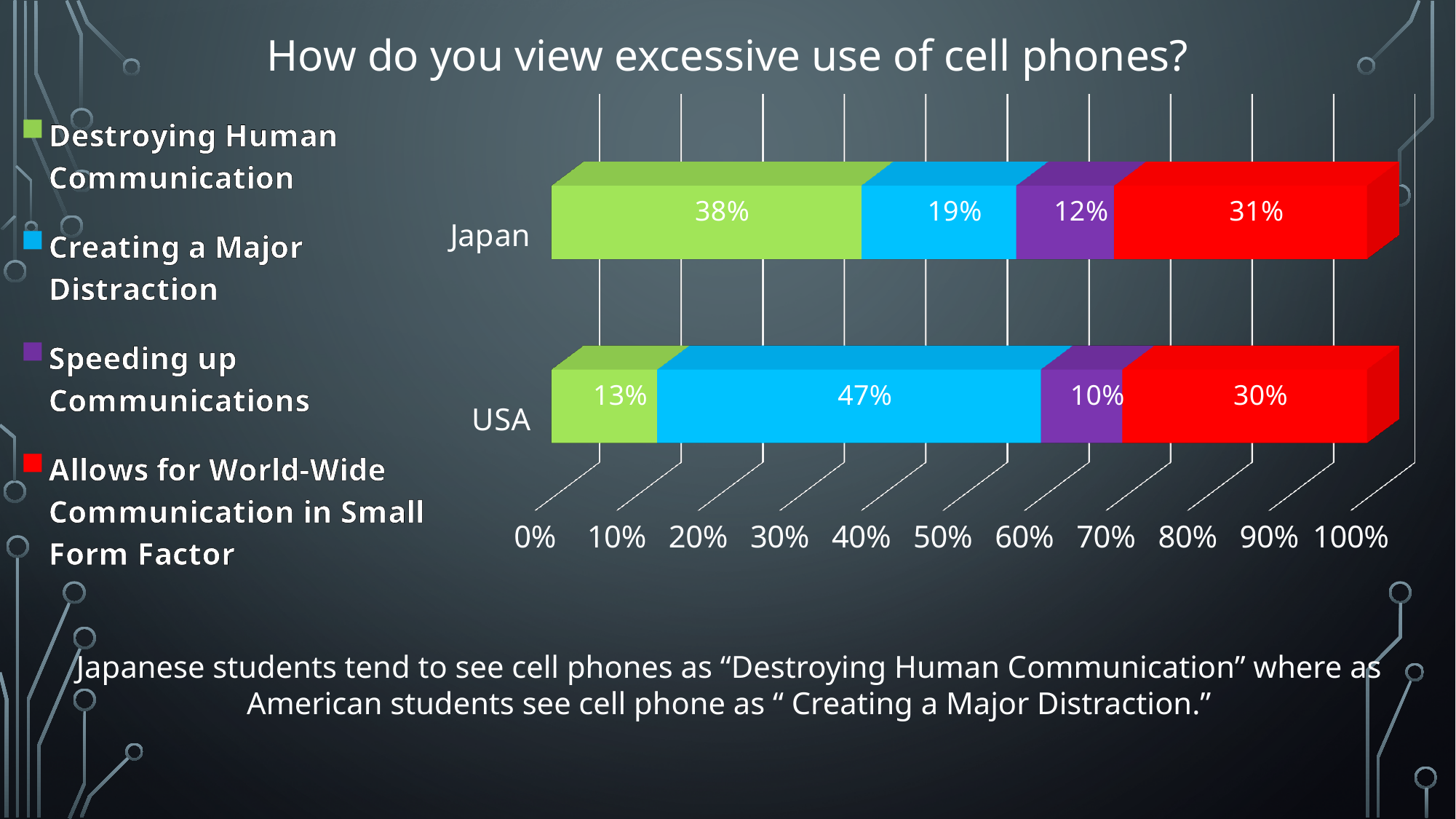
What kind of chart is shown on the slide? Stacked bar chart What is the value for "Allows for World-Wide Communication in Small Form Factor" for USA? 30% Which is larger: the "Creating a Major Distraction" value for Japan or for USA? USA How many series does the legend list? 4 What percentage of USA respondents chose "Creating a Major Distraction"? 47% What is the value for "Speeding up Communications" for Japan? 12% Which response category has the lowest value for the Japan bar? Speeding up Communications How many countries are shown on the chart? 2 What is the total of the Japan stacked bar? 100% What is the difference between the Japan and USA values for "Destroying Human Communication"? 25% Which response category has the highest value for the USA bar? Creating a Major Distraction What percentage of Japan respondents chose "Destroying Human Communication"? 38%